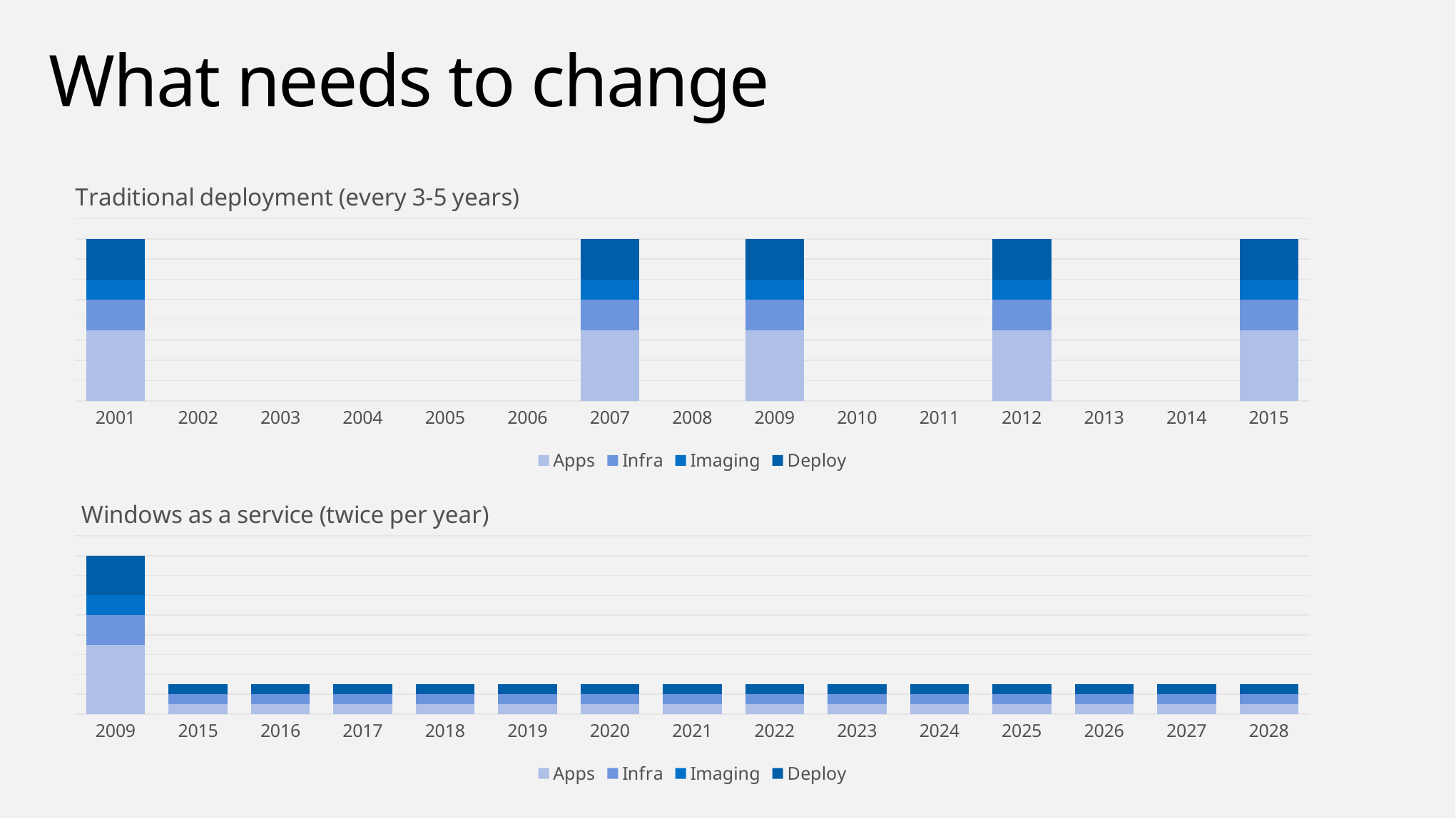
In the 'Traditional deployment (every 3-5 years)' chart, what are the legend entries? Apps, Infra, Imaging, Deploy In the 'Windows as a service (twice per year)' chart, which year has the tallest bar? 2009 In the 'Windows as a service (twice per year)' chart, which is larger, the bar for 2009 or the bar for 2015? 2009 How many years are shown on the x axis of the 'Traditional deployment (every 3-5 years)' chart? 15 How many years are shown on the x axis of the 'Windows as a service (twice per year)' chart? 15 In the 'Windows as a service (twice per year)' chart, which segment of the 2009 bar is larger, Apps or Deploy? Apps In the 'Windows as a service (twice per year)' chart, which series forms the bottom segment of each stacked bar? Apps In the 'Traditional deployment (every 3-5 years)' chart, which is larger, the bar for 2001 or the bar for 2002? 2001 In the 'Traditional deployment (every 3-5 years)' chart, how many series does the legend list? 4 In the 'Traditional deployment (every 3-5 years)' chart, how many of the years have a bar plotted? 5 What kind of chart is the 'Traditional deployment (every 3-5 years)' chart? Stacked bar chart In the 'Windows as a service (twice per year)' chart, do the bar totals rise, fall or stay the same from 2015 to 2028? Stay the same